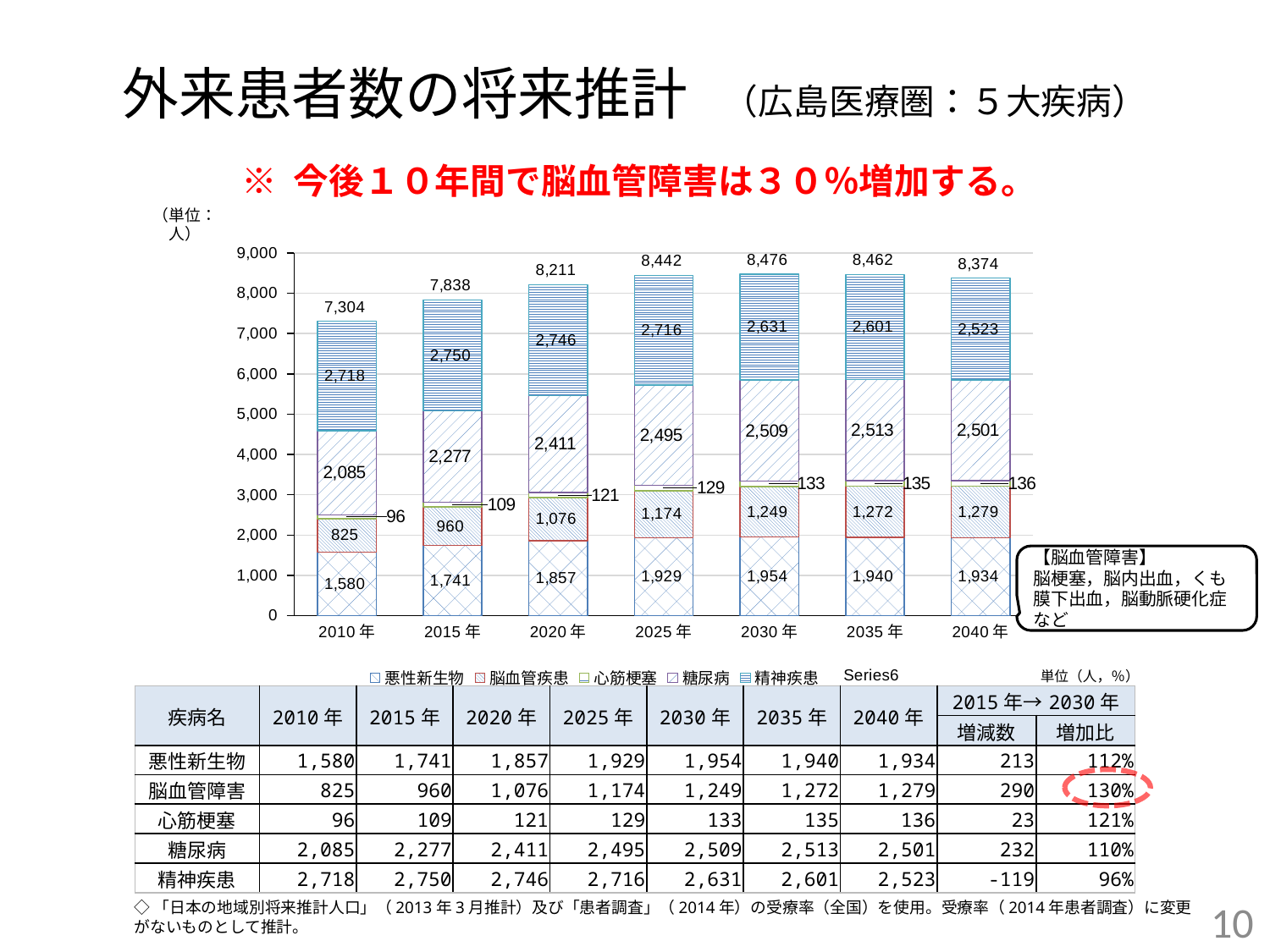
Which year has the highest total outpatient count? 2030年 What is the value for 悪性新生物 in 2010年? 1,580 Which year has the lowest total outpatient count? 2010年 What is the total shown above the stacked bar for 2030年? 8,476 What is the value for 糖尿病 in 2025年? 2,495 What type of chart is shown on the slide? stacked bar chart What unit is indicated for the chart values? 人 How many years (categories) are plotted along the x axis of the chart? 7 What is the difference between the 精神疾患 values for 2010年 and 2040年? 195 Which is larger, the 心筋梗塞 value in 2015年 or in 2035年? 2035年 How many series does the chart legend list? 6 What is the value for 脳血管疾患 in 2040年? 1,279